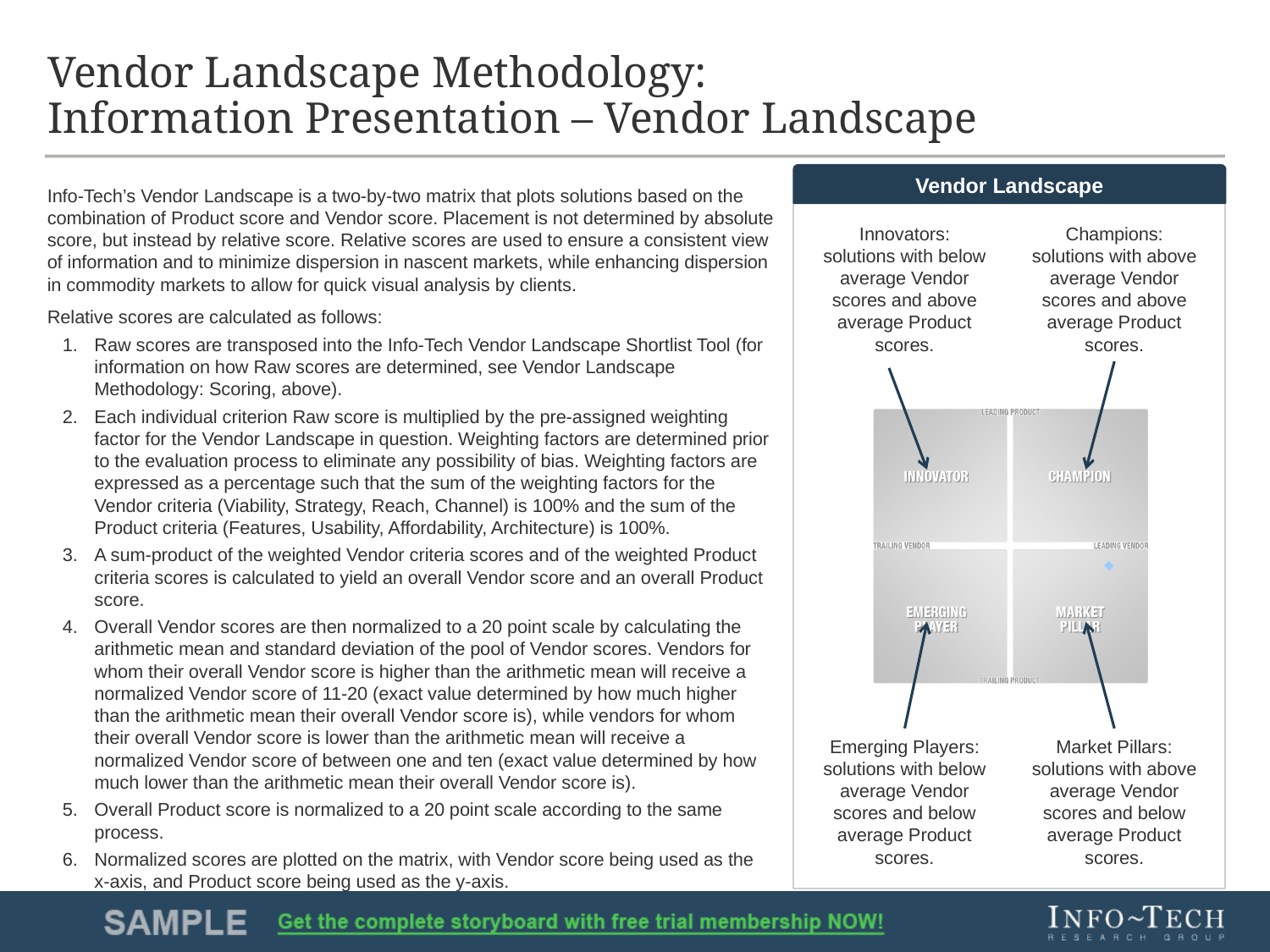
Which quadrant of the Vendor Landscape matrix is in the bottom-left position? Emerging Player Which quadrant of the Vendor Landscape matrix is in the top-right position? Champion How many data points are plotted on the Vendor Landscape matrix? 1 What kind of chart is the Vendor Landscape diagram? Two-by-two matrix Which quadrant of the Vendor Landscape matrix represents solutions with below average Vendor scores and above average Product scores? Innovator In which quadrant of the Vendor Landscape matrix is the single plotted point located? Market Pillar How many quadrants does the Vendor Landscape matrix have? 4 What label appears at the top edge of the Vendor Landscape matrix? Leading Product What is the title of the chart on the right side of the slide? Vendor Landscape